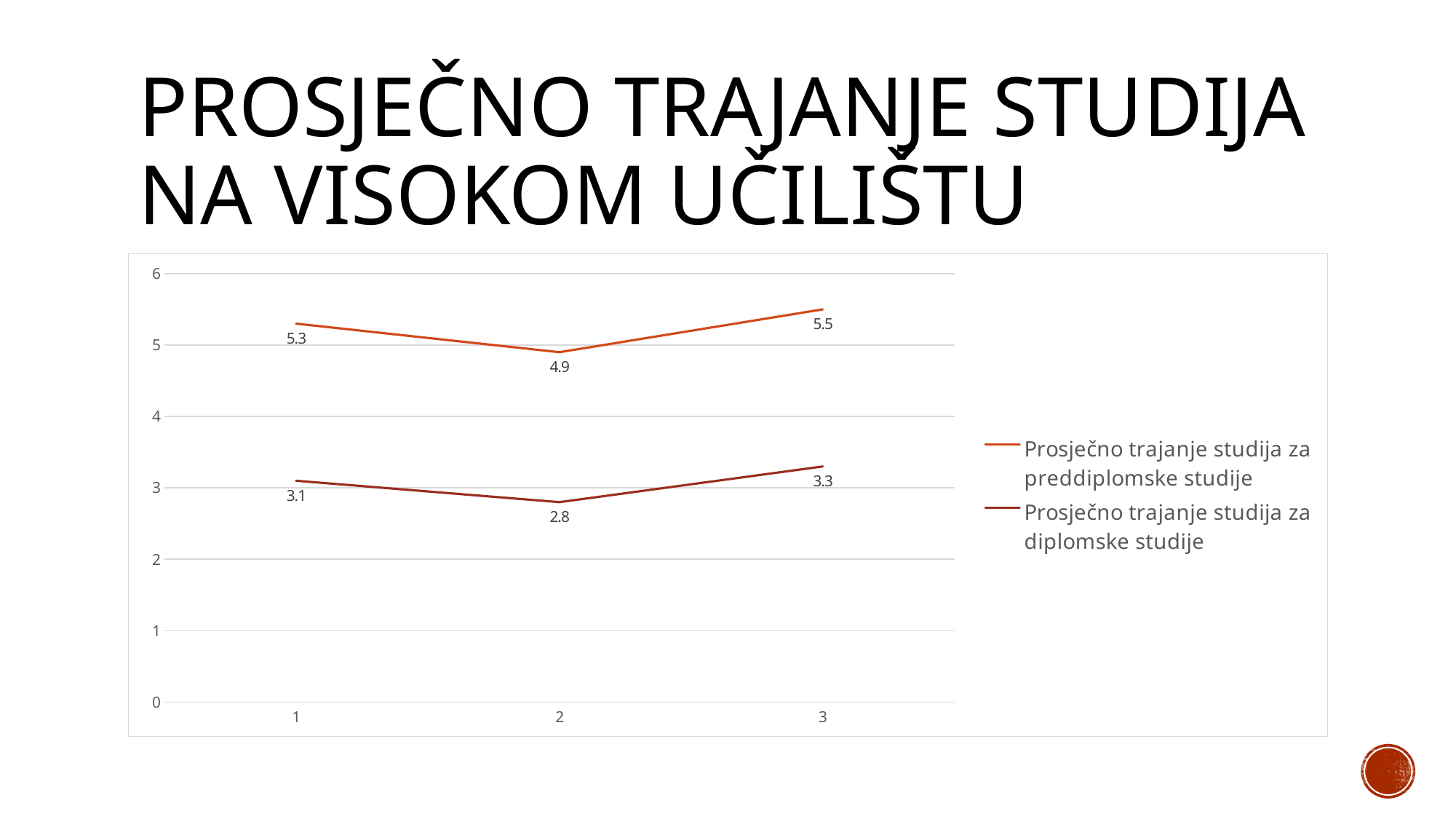
Is the value for 'Prosječno trajanje studija za diplomske studije' at category 1 greater or less than 4? less At which category is 'Prosječno trajanje studija za preddiplomske studije' lowest? 2 What is the value for 'Prosječno trajanje studija za diplomske studije' at category 2? 2.8 What is the value for 'Prosječno trajanje studija za preddiplomske studije' at category 3? 5.5 How many categories are shown on the x axis? 3 What is the difference between the value at category 3 and category 2 for 'Prosječno trajanje studija za diplomske studije'? 0.5 Which series has the larger value at category 2? Prosječno trajanje studija za preddiplomske studije What is the difference between the two series at category 1? 2.2 How many series does the legend list? 2 What is the value for 'Prosječno trajanje studija za preddiplomske studije' at category 1? 5.3 What kind of chart is shown on the slide? line chart At which category is 'Prosječno trajanje studija za diplomske studije' highest? 3